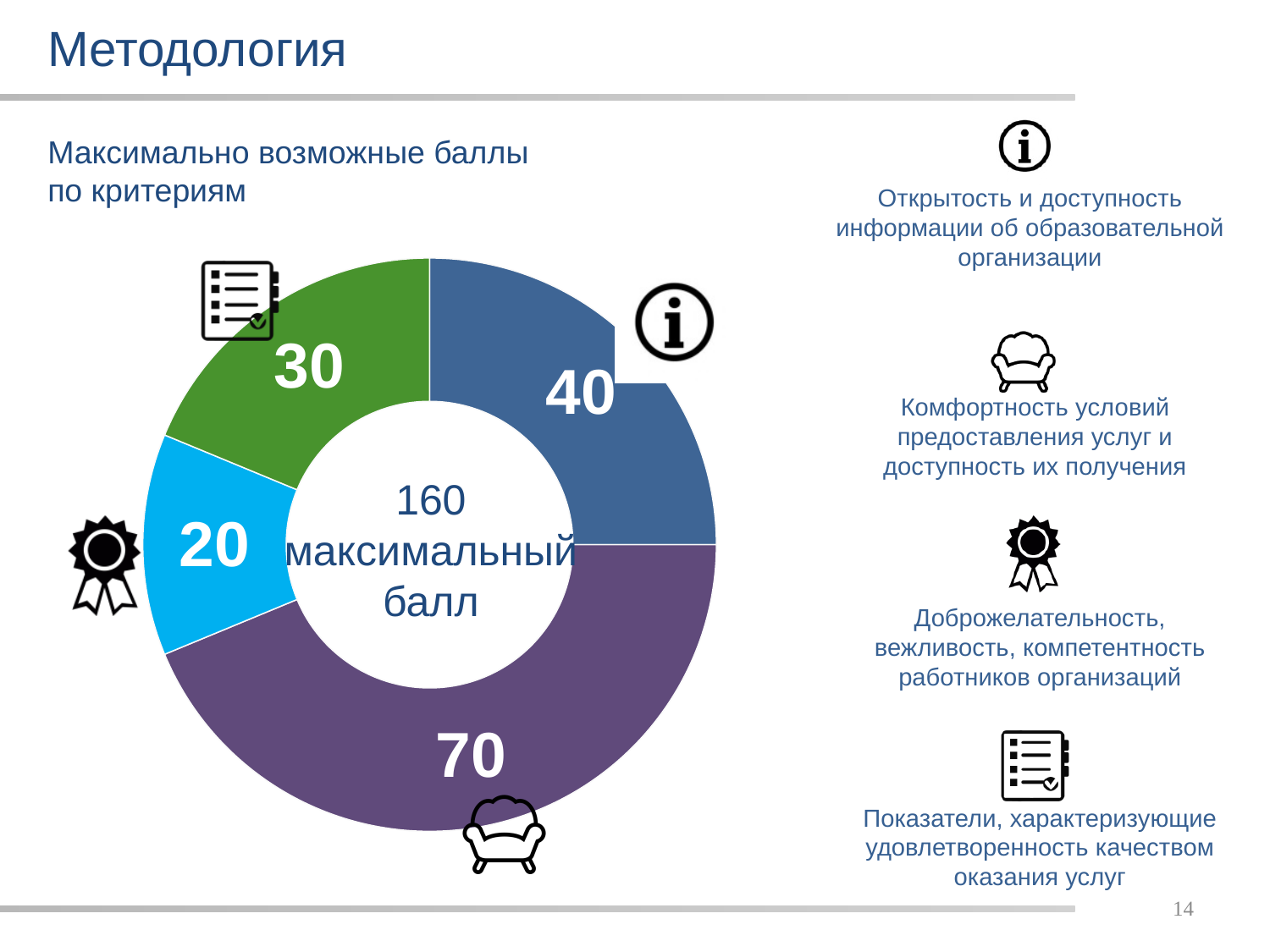
What share of the total 160 does the purple segment (70) represent? 43.75% What value is shown on the light blue segment of the donut chart? 20 Which is larger: the dark blue segment or the green segment? The dark blue segment (40) What kind of chart is shown on the slide? Pie (donut) chart Which segment of the donut chart has the lowest value? The light blue segment (20) What is the difference between the purple segment (70) and the dark blue segment (40)? 30 What value is shown on the purple segment of the donut chart? 70 What value is shown on the dark blue segment of the donut chart? 40 Which segment of the donut chart has the highest value? The purple segment (70) What value is shown on the green segment of the donut chart? 30 What is the total of all segments shown in the centre of the donut chart? 160 How many segments does the donut chart have? 4